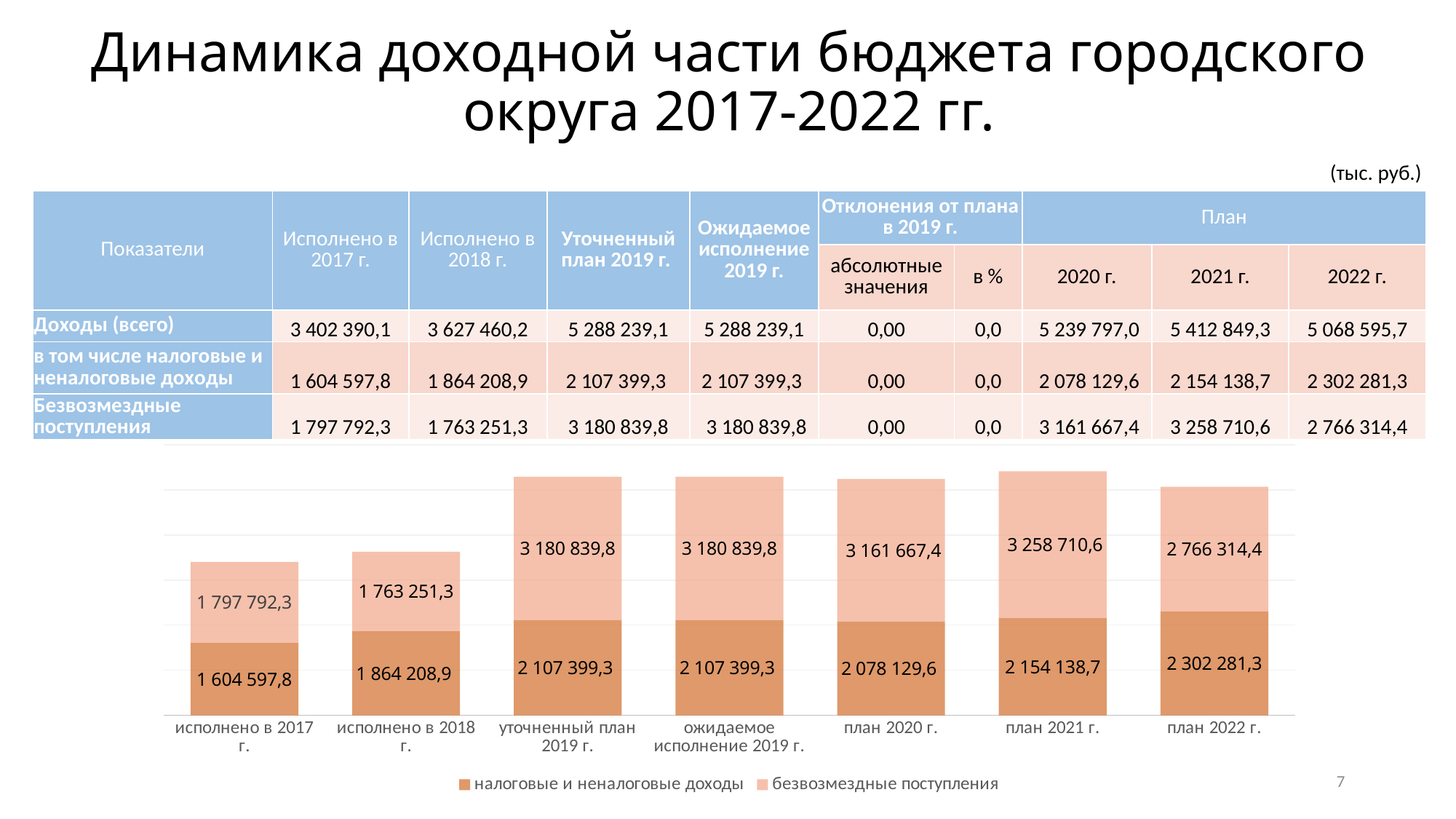
What is the difference between налоговые и неналоговые доходы for план 2022 г. and for исполнено в 2017 г. in the chart? 697 683,5 What is the value of налоговые и неналоговые доходы for план 2022 г. in the chart? 2 302 281,3 Which category has the highest value for налоговые и неналоговые доходы in the chart? план 2022 г. Which legend entry is shown in the darker orange colour in the chart? налоговые и неналоговые доходы How many series does the chart legend list? 2 Which category has the lowest value for безвозмездные поступления in the chart? исполнено в 2018 г. Which is larger in the chart: безвозмездные поступления for план 2021 г. or for план 2022 г.? план 2021 г. What is the total of the stacked bar for план 2021 г. in the chart? 5 412 849,3 How many categories are shown along the x axis of the chart? 7 What is the value of безвозмездные поступления for исполнено в 2018 г. in the chart? 1 763 251,3 What is the value of безвозмездные поступления for план 2020 г. in the chart? 3 161 667,4 What type of chart is shown on the slide? stacked bar chart